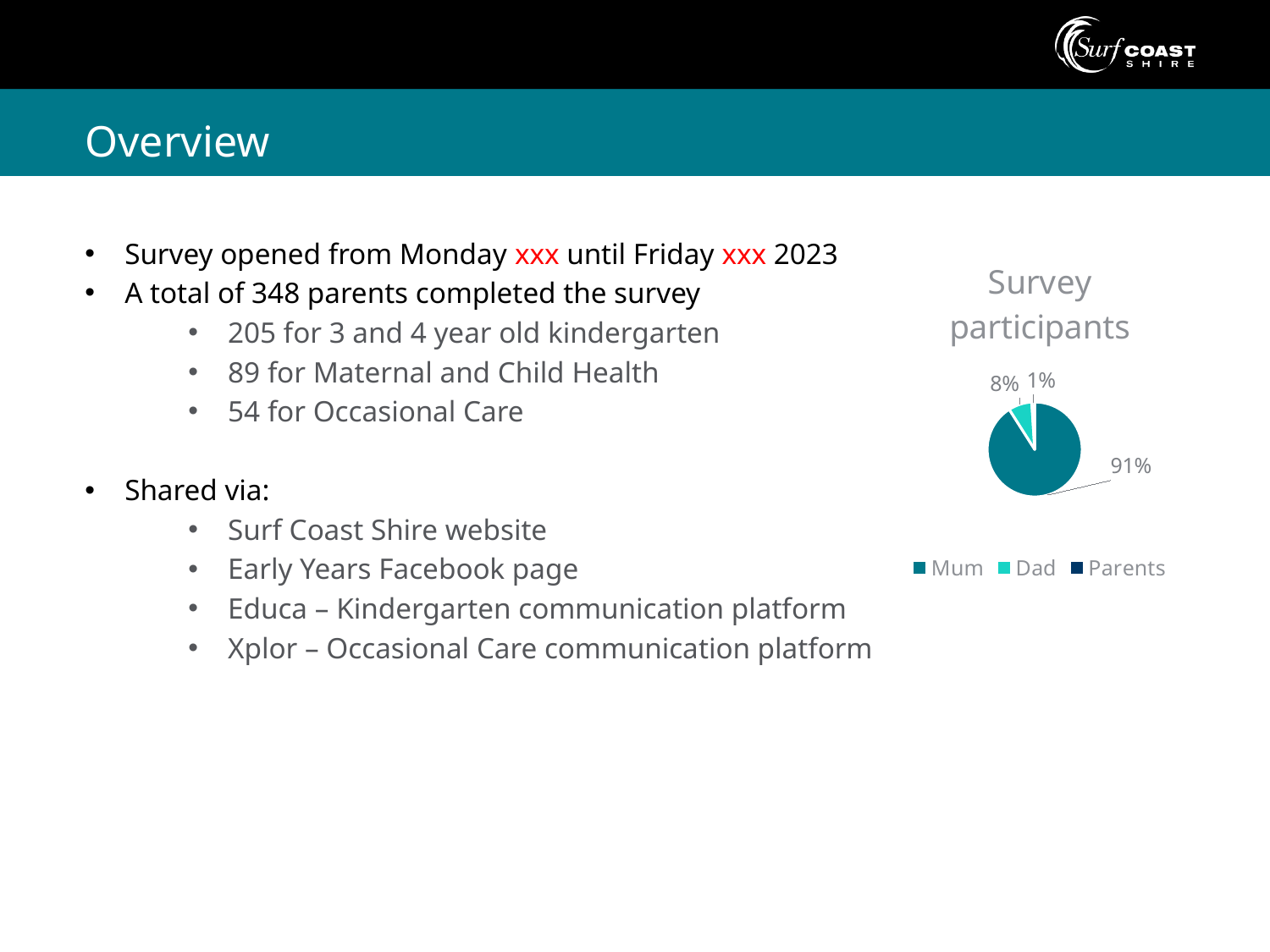
What kind of chart is shown on the slide? pie chart Which category has the smallest slice of the pie? Parents What is the title of the chart? Survey participants What share of survey participants were Mum? 91% What are the three legend entries of the chart? Mum, Dad, Parents How many slices does the pie chart have? 3 What share of survey participants were Parents? 1% Which category has the largest slice of the pie? Mum Which is larger, the Dad slice or the Parents slice? Dad How many categories does the legend list? 3 What share of survey participants were Dad? 8% What is the difference in percentage points between the Mum and Dad slices? 83